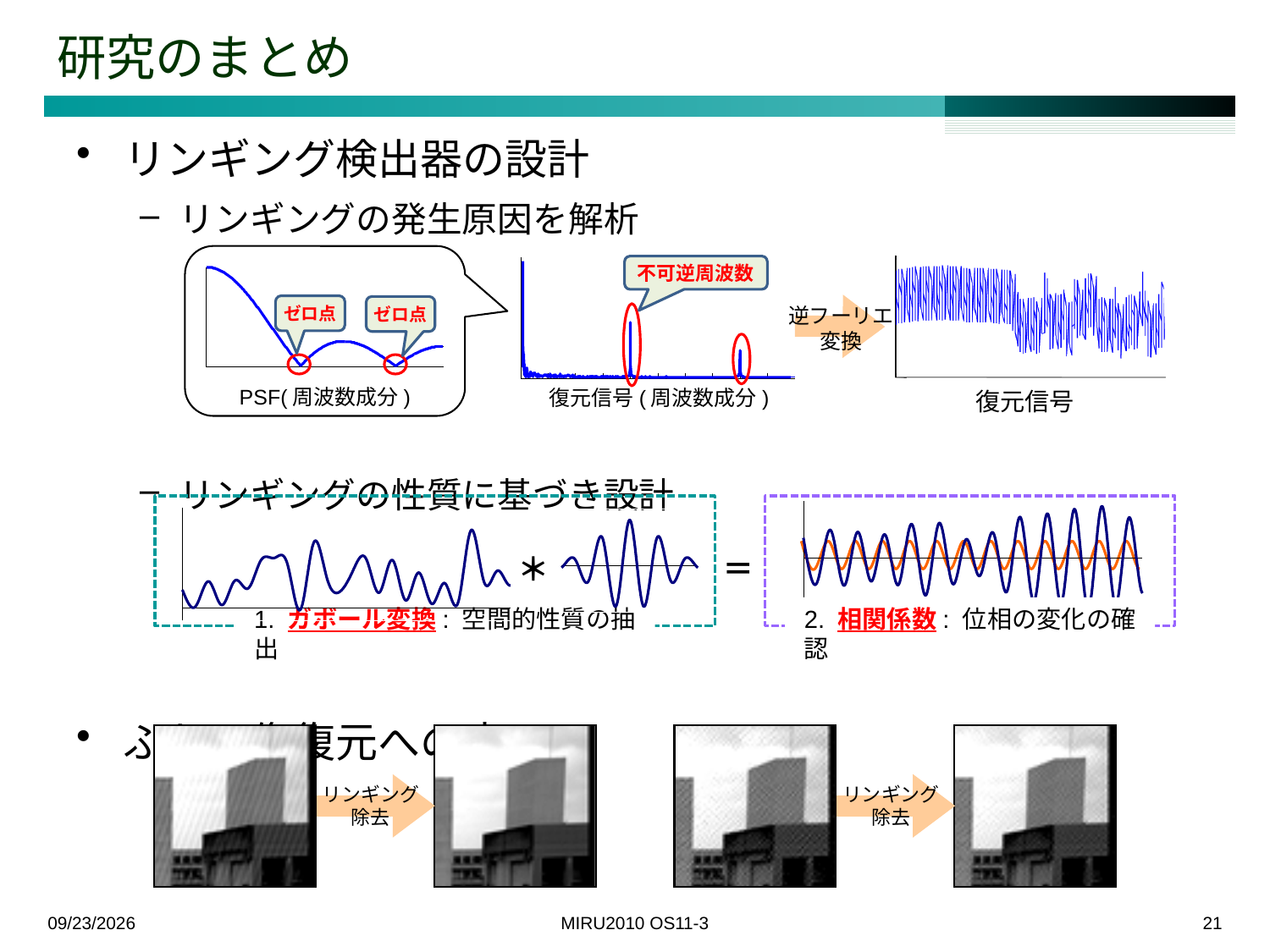
What is the label under the rightmost plot in the top row? 復元信号 How many lines are plotted in the 相関係数 plot on the right of the middle row? 2 How many ゼロ点 (zero points) are circled in red on the PSF(周波数成分) plot? 2 In the 復元信号(周波数成分) plot, where is the tallest peak located: at the left edge or at the right edge? at the left edge In the PSF(周波数成分) plot, does the curve rise or fall from the left edge to the first ゼロ点? fall How many peaks are circled in red in the 復元信号(周波数成分) plot? 2 What is the label under the leftmost plot in the top row? PSF(周波数成分) What type of chart is the plot labelled PSF(周波数成分)? line chart